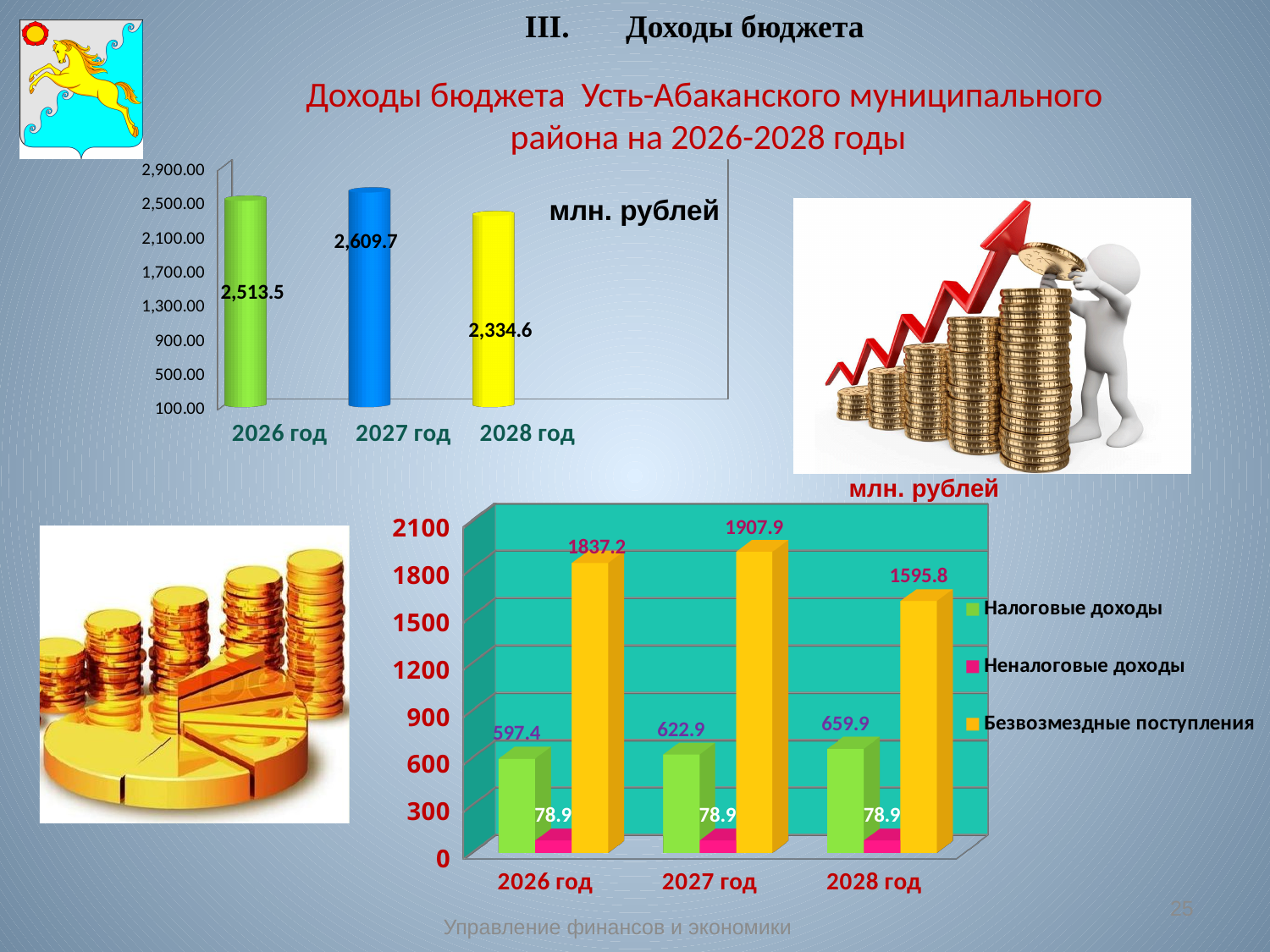
In the bottom chart, what is the value of Безвозмездные поступления for 2027 год? 1907.9 In the top chart, which year has the lowest value? 2028 год In the top chart, which year has the highest value? 2027 год In the top chart, how many years are shown? 3 What kind of chart is the top chart? bar chart In the bottom chart, do the values of Налоговые доходы rise or fall from 2026 год to 2028 год? rise In the bottom chart, which is larger: Безвозмездные поступления for 2026 год or for 2028 год? 2026 год In the top chart, what is the difference between the values for 2027 год and 2028 год? 275.1 In the bottom chart, what is the value of Налоговые доходы for 2028 год? 659.9 In the top chart, what is the value for 2027 год? 2,609.7 In the bottom chart, how many series does the legend list? 3 In the bottom chart, what is the difference between Налоговые доходы for 2027 год and 2026 год? 25.5